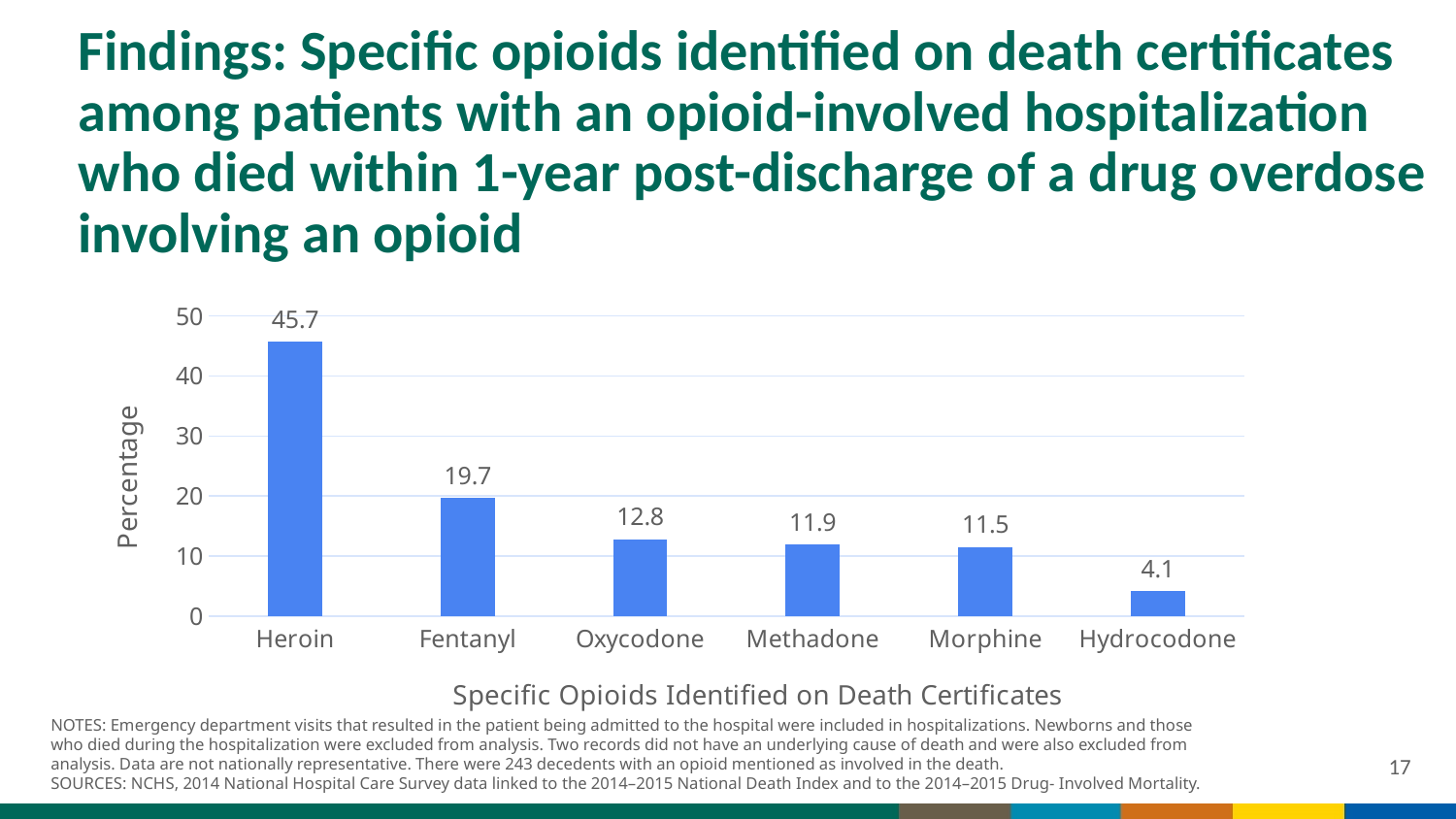
What is the percentage for Heroin? 45.7 What is the percentage for Hydrocodone? 4.1 Which opioid has the lowest percentage? Hydrocodone How many opioid categories are shown on the x axis? 6 What is the difference between the percentages for Oxycodone and Hydrocodone? 8.7 What is the percentage for Fentanyl? 19.7 Which has a larger percentage, Fentanyl or Oxycodone? Fentanyl What is the label of the y axis? Percentage What is the difference between the percentages for Heroin and Fentanyl? 26 What kind of chart is shown on the slide? Bar chart Which opioid has the highest percentage? Heroin Is the value for Methadone greater or less than 10? greater